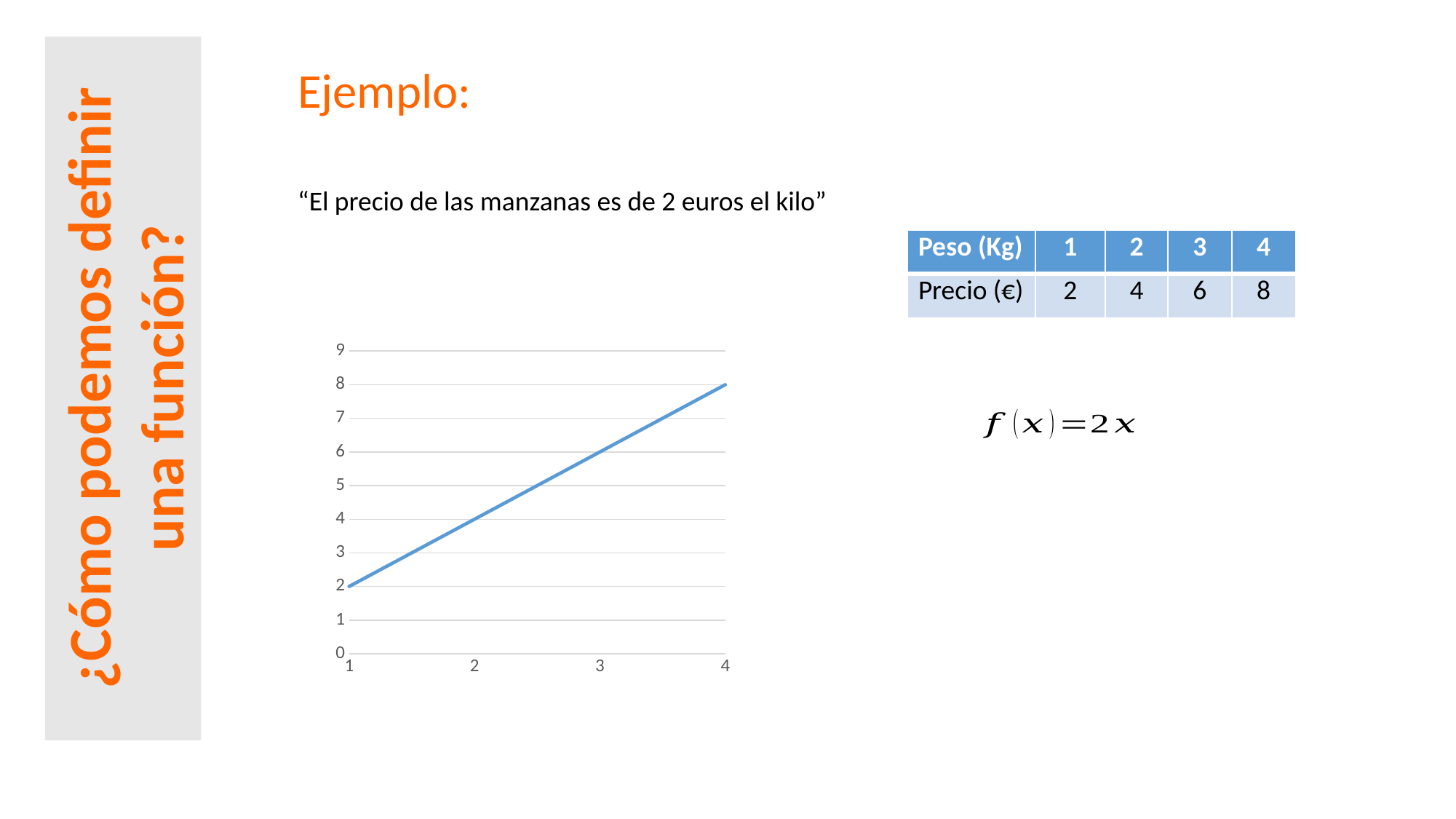
Do the values rise or fall as x increases from 1 to 4? rise What is the value plotted at x = 1 on the line chart? 2 What is the difference between the value at x = 4 and the value at x = 1? 6 What is the value plotted at x = 3 on the line chart? 6 What is the value plotted at x = 2 on the line chart? 4 What is the value plotted at x = 4 on the line chart? 8 What is the highest value labelled on the vertical axis of the chart? 9 What kind of chart is shown on the slide? line chart At which x value does the line have its lowest value? 1 Is the value at x = 3 greater or less than 5? greater At which x value does the line reach its highest point? 4 How many x-axis tick labels are shown on the chart? 4